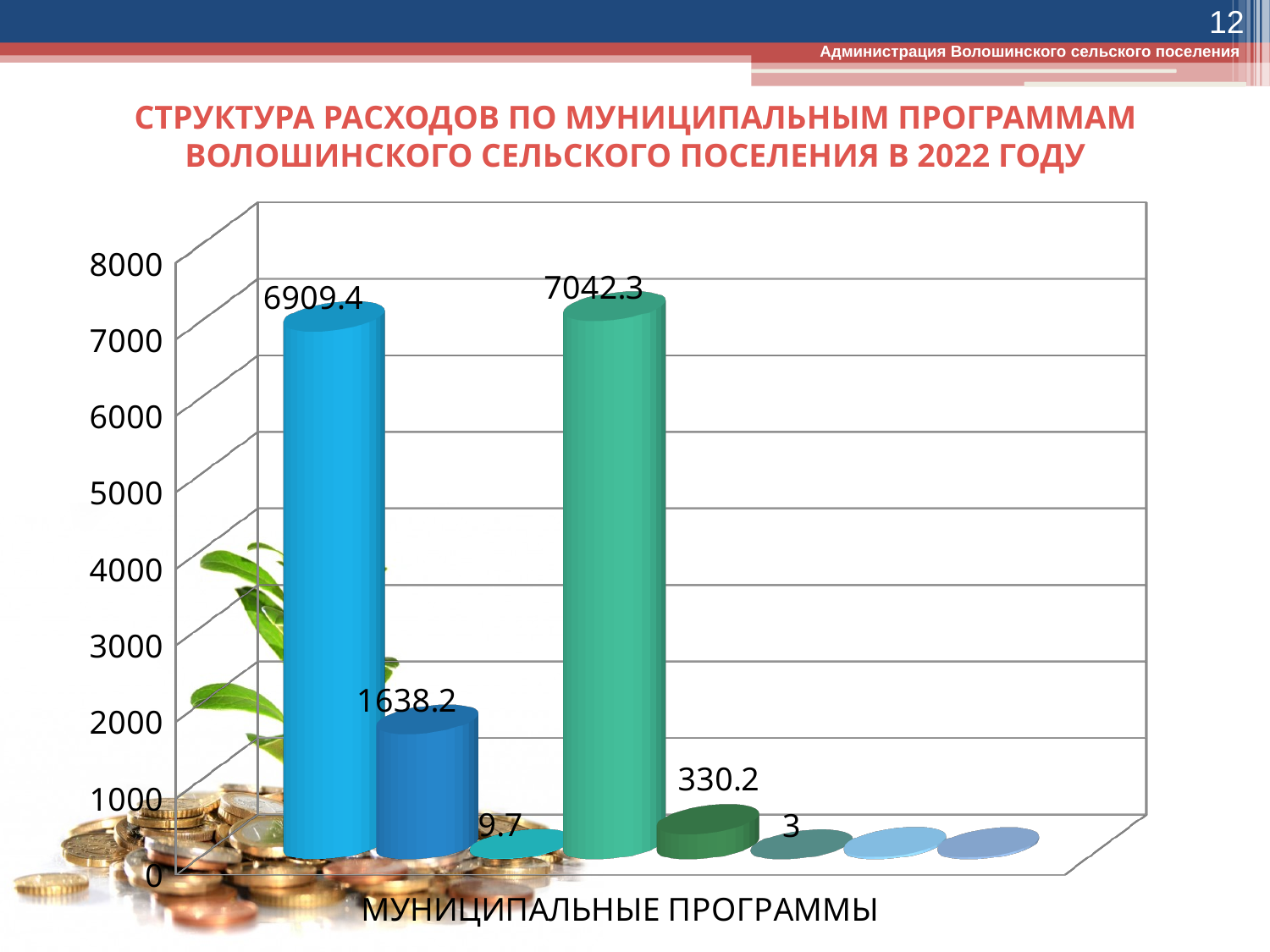
Which is larger: the value of the leftmost light blue bar or the value of the tallest green bar? the tallest green bar (7042.3) What is the label on the horizontal axis of the chart? МУНИЦИПАЛЬНЫЕ ПРОГРАММЫ Is the value of the leftmost light blue bar greater or less than 6000? greater What is the value shown on the second (dark blue) bar? 1638.2 What is the largest value labelled on the chart? 7042.3 What is the value shown on the first (leftmost, light blue) bar? 6909.4 What is the difference between the two largest values, 7042.3 and 6909.4? 132.9 How many bars are plotted on the chart? 8 What is the value shown on the dark green bar to the right of the tallest bar? 330.2 What is the title of the chart on the slide? СТРУКТУРА РАСХОДОВ ПО МУНИЦИПАЛЬНЫМ ПРОГРАММАМ ВОЛОШИНСКОГО СЕЛЬСКОГО ПОСЕЛЕНИЯ В 2022 ГОДУ What type of chart is shown on the slide? bar chart What is the value shown on the tallest green bar? 7042.3